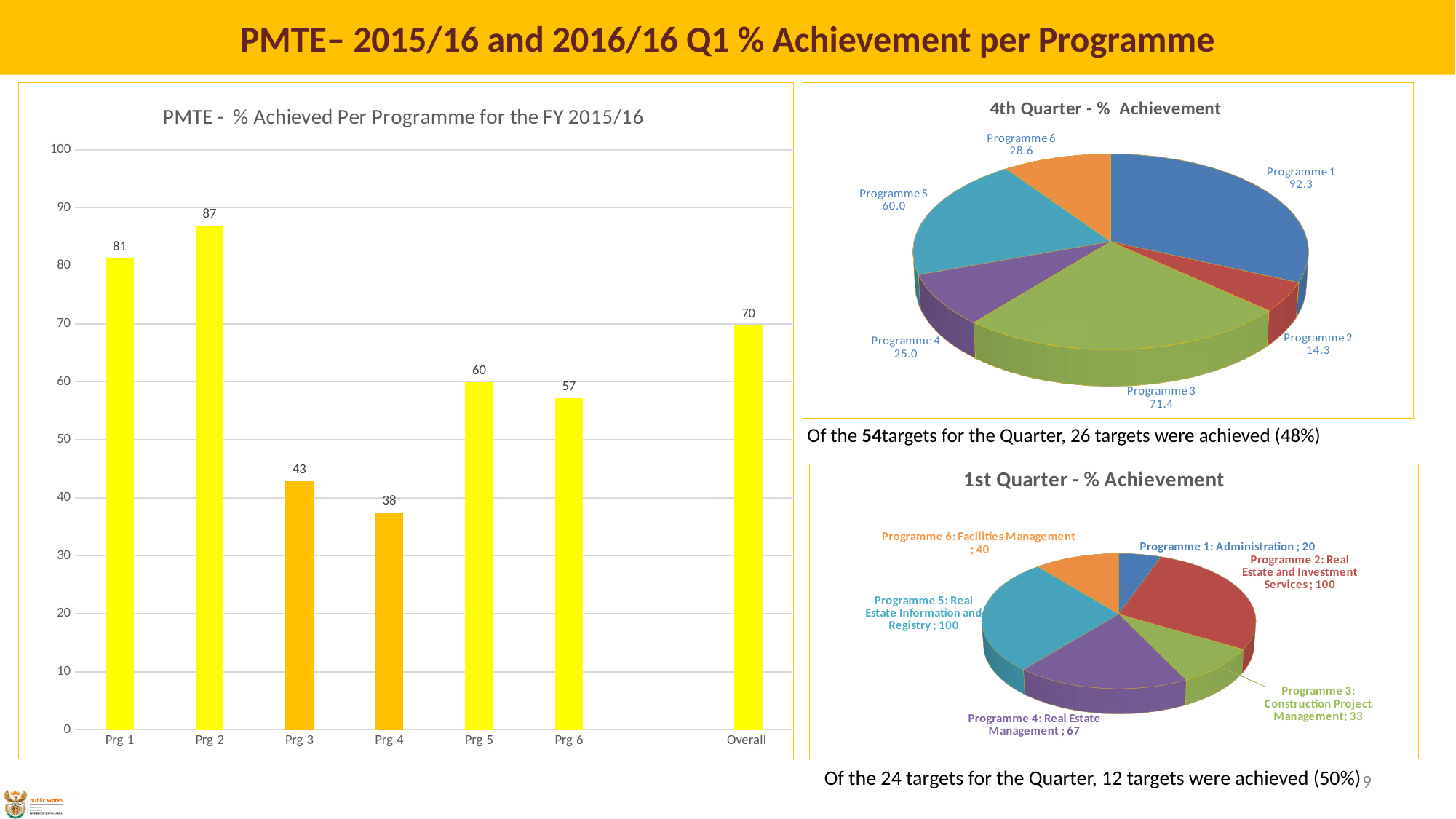
In the chart titled "PMTE - % Achieved Per Programme for the FY 2015/16", which is larger, the value for Prg 5 or the value for Prg 6? Prg 5 In the chart titled "PMTE - % Achieved Per Programme for the FY 2015/16", how many bars are plotted? 7 In the chart titled "PMTE - % Achieved Per Programme for the FY 2015/16", which programme has the highest value? Prg 2 In the chart titled "PMTE - % Achieved Per Programme for the FY 2015/16", which programme has the lowest value? Prg 4 In the chart titled "4th Quarter - % Achievement", which programme has the lowest value? Programme 2 In the chart titled "PMTE - % Achieved Per Programme for the FY 2015/16", what is the value for Prg 2? 87 What kind of chart is the chart titled "PMTE - % Achieved Per Programme for the FY 2015/16"? Bar chart In the chart titled "4th Quarter - % Achievement", what is the value for Programme 3? 71.4 In the chart titled "PMTE - % Achieved Per Programme for the FY 2015/16", what is the difference between the values for Prg 1 and Prg 3? 38 In the chart titled "PMTE - % Achieved Per Programme for the FY 2015/16", what is the value for Overall? 70 What kind of chart is the chart titled "1st Quarter - % Achievement"? Pie chart In the chart titled "1st Quarter - % Achievement", what is the value for Programme 4: Real Estate Management? 67